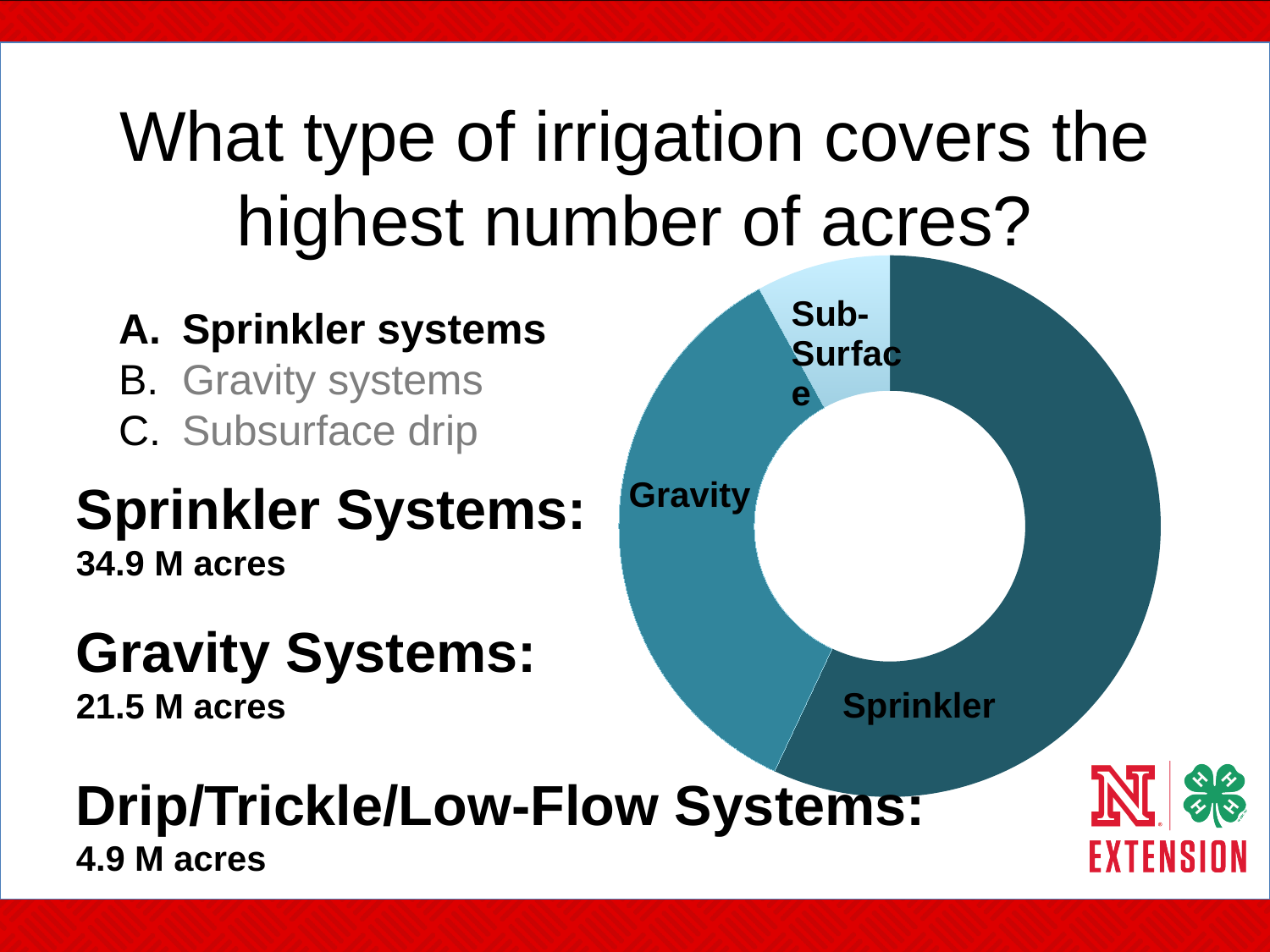
How many segments does the doughnut chart have? 3 Which segment of the doughnut chart is the smallest? Sub-Surface What are the three segment labels shown on the doughnut chart? Sprinkler, Gravity, Sub-Surface Which segment of the doughnut chart is drawn in the lightest blue? Sub-Surface How many acres do sprinkler systems cover according to the slide? 34.9 M acres What kind of chart is shown on the slide? doughnut chart How many more acres do sprinkler systems cover than gravity systems? 13.4 M acres How many acres do gravity systems cover according to the slide? 21.5 M acres Which segment is larger, Gravity or Sub-Surface? Gravity Which segment of the doughnut chart is the largest? Sprinkler Which segment is larger, Sprinkler or Gravity? Sprinkler